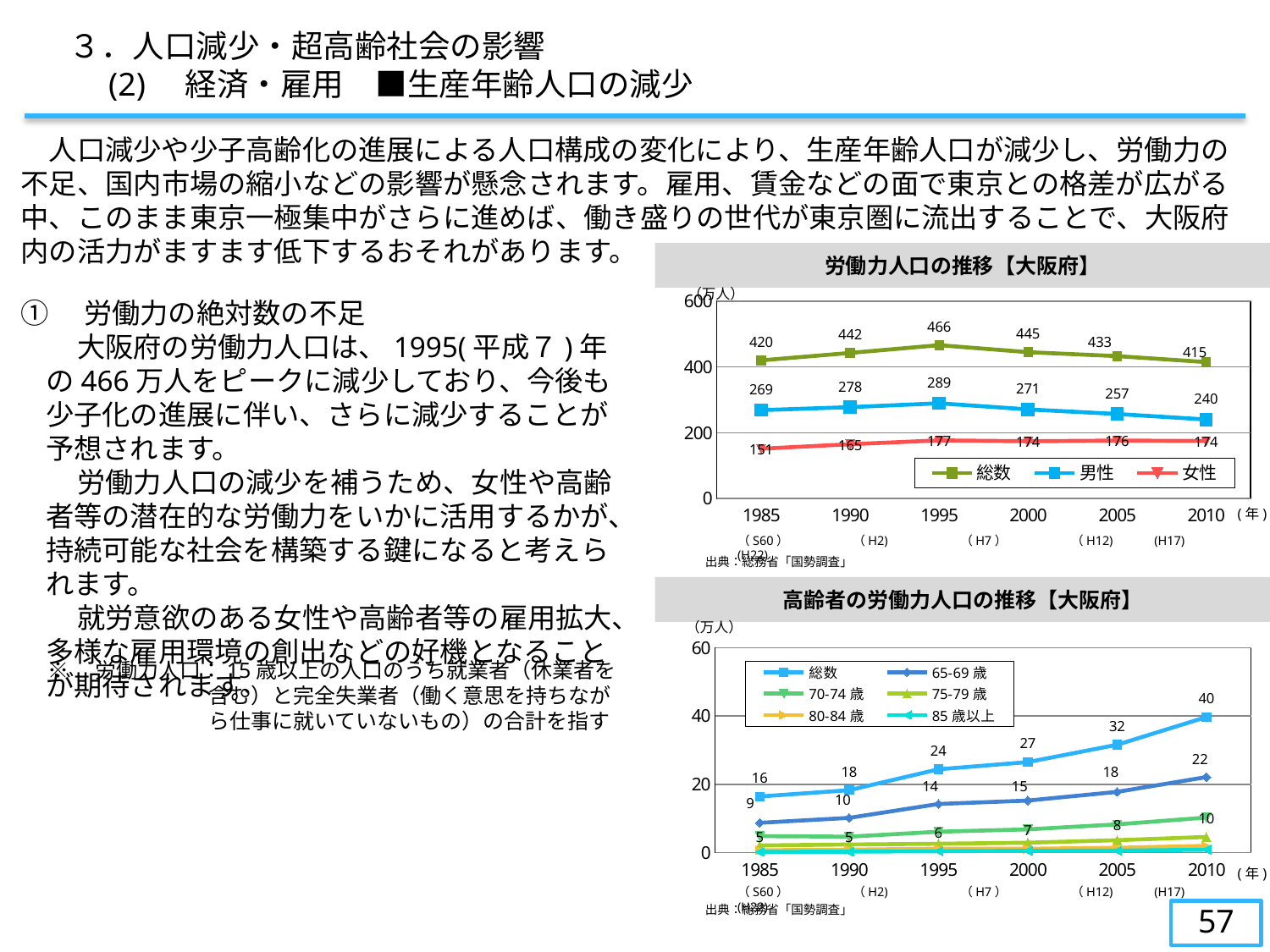
In the chart titled 労働力人口の推移【大阪府】, how many series does the legend list? 3 In the chart titled 労働力人口の推移【大阪府】, in which year is 総数 highest? 1995 In the chart titled 高齢者の労働力人口の推移【大阪府】, what is the value of 65-69歳 in 2005? 18 In the chart titled 高齢者の労働力人口の推移【大阪府】, how many series does the legend list? 6 In the chart titled 労働力人口の推移【大阪府】, what kind of chart is it? line chart In the chart titled 労働力人口の推移【大阪府】, what is the value of 男性 in 2010? 240 In the chart titled 高齢者の労働力人口の推移【大阪府】, how many years are plotted on the x axis? 6 In the chart titled 労働力人口の推移【大阪府】, what is the difference between 総数 in 1995 and 総数 in 2010? 51 In the chart titled 高齢者の労働力人口の推移【大阪府】, does the 総数 series rise or fall from 1985 to 2010? rise In the chart titled 労働力人口の推移【大阪府】, what is the value of 総数 in 1995? 466 In the chart titled 高齢者の労働力人口の推移【大阪府】, what is the value of 総数 in 2010? 40 In the chart titled 労働力人口の推移【大阪府】, in which year is 女性 lowest? 1985